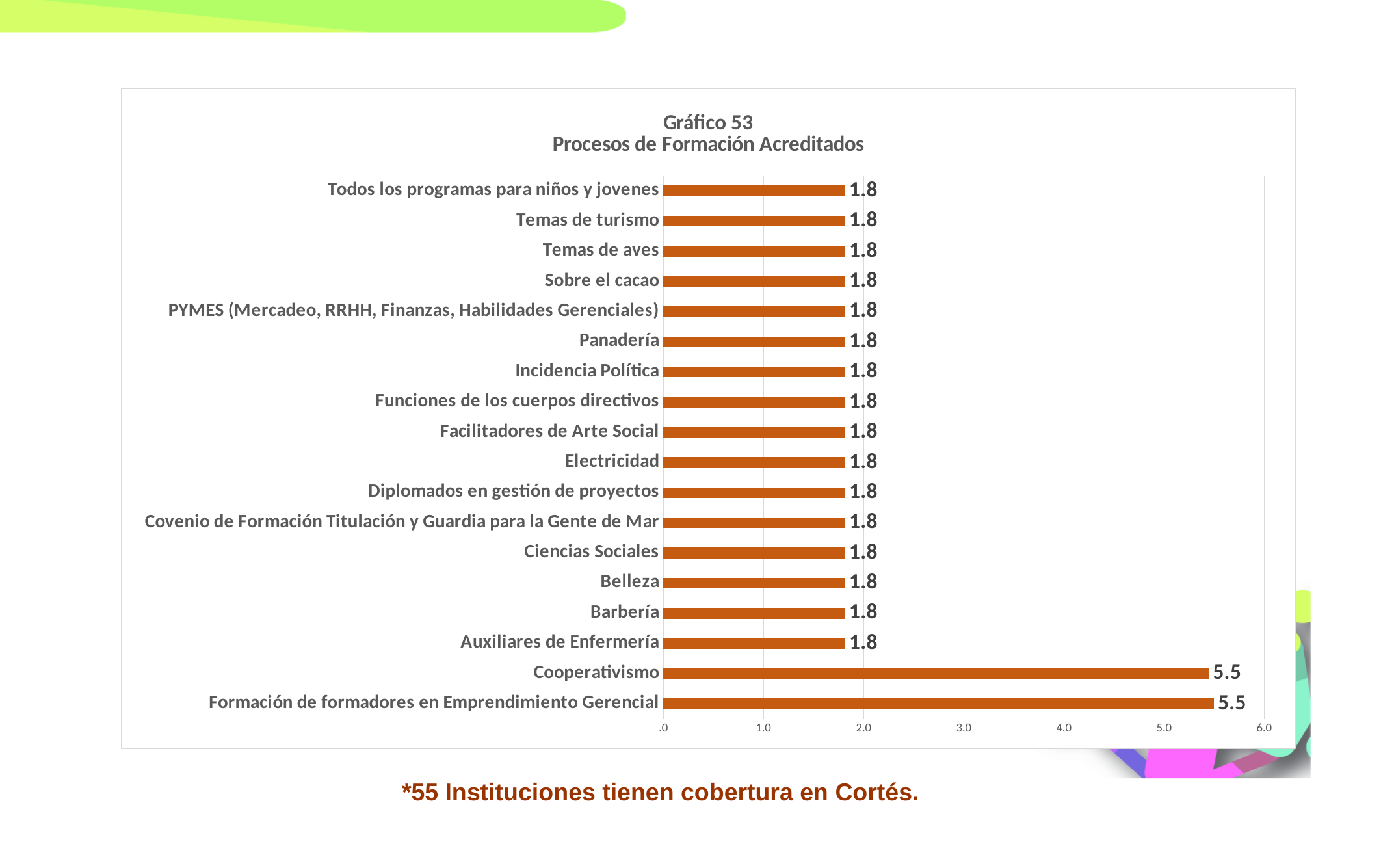
What kind of chart is shown on the slide? Bar chart Which has a larger value, Barbería or Formación de formadores en Emprendimiento Gerencial? Formación de formadores en Emprendimiento Gerencial What is the title of the chart? Gráfico 53 Procesos de Formación Acreditados What is the highest value shown in the chart? 5.5 What is the difference between the values for Cooperativismo and Belleza? 3.7 How many categories are shown in the chart? 18 Is the value for Cooperativismo greater or less than 5.0? greater What is the lowest value shown in the chart? 1.8 What is the value for Electricidad? 1.8 What is the value for Cooperativismo? 5.5 What is the value for Temas de turismo? 1.8 What is the value for Formación de formadores en Emprendimiento Gerencial? 5.5